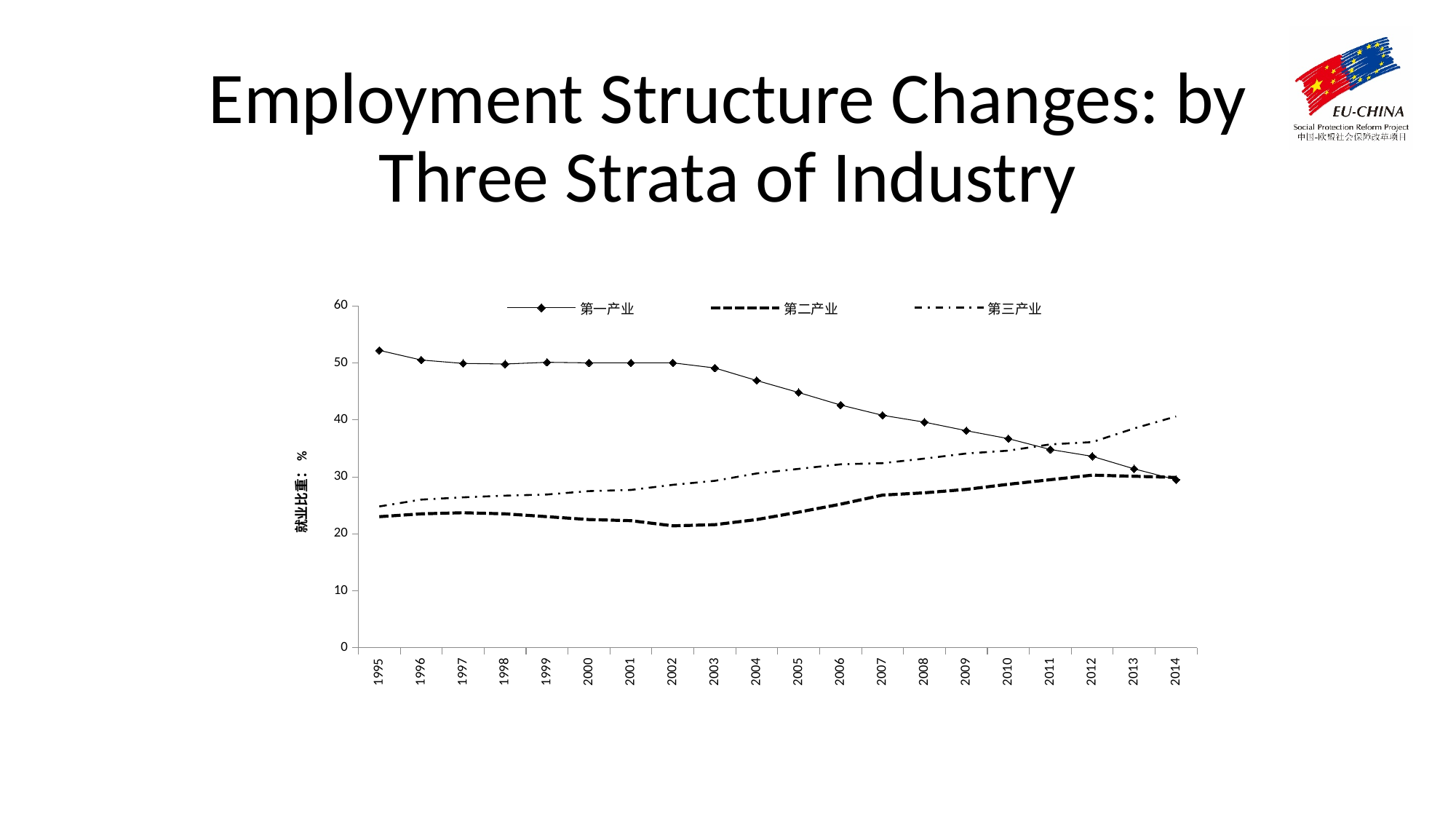
Is the value for 第三产业 in 1995 greater or less than 30? less In 2014, which series has the larger value, 第一产业 or 第三产业? 第三产业 Does the 第三产业 series rise or fall from 1995 to 2014? rise How many series does the legend list? 3 In which year is the 第一产业 series at its highest? 1995 How many years are shown on the x axis? 20 What kind of chart is shown on the slide? line chart Does the 第一产业 series rise or fall from 1995 to 2014? fall Is the value for 第一产业 in 1995 greater or less than 50? greater In which year is the 第三产业 series at its highest? 2014 In which year is the 第一产业 series at its lowest? 2014 Is the value for 第一产业 in 2010 greater or less than 40? less